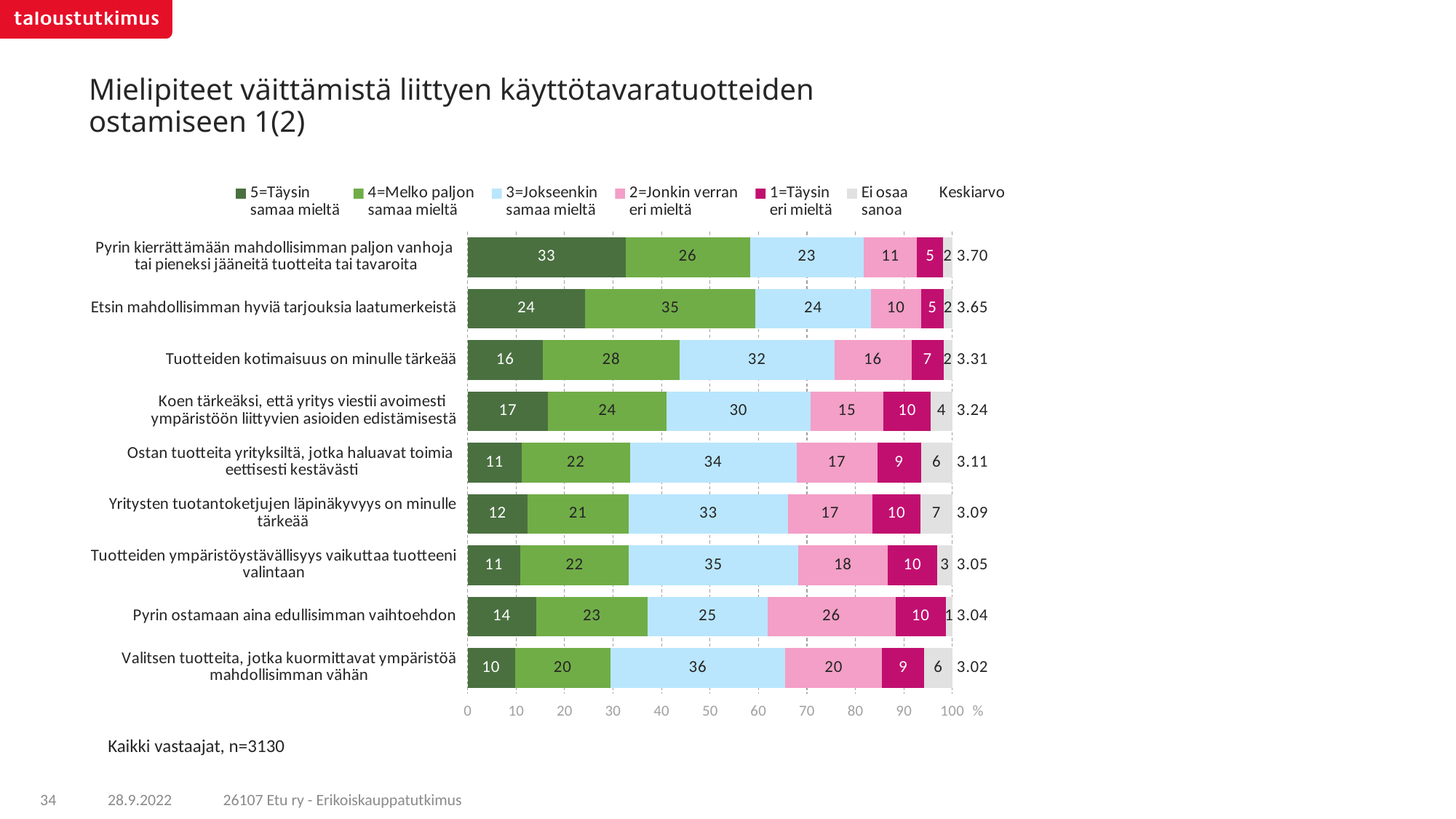
What is the "3=Jokseenkin samaa mieltä" value for "Valitsen tuotteita, jotka kuormittavat ympäristöä mahdollisimman vähän"? 36 Which statement has the lowest Keskiarvo? Valitsen tuotteita, jotka kuormittavat ympäristöä mahdollisimman vähän What percentage of respondents answered "5=Täysin samaa mieltä" to "Pyrin kierrättämään mahdollisimman paljon vanhoja tai pieneksi jääneitä tuotteita tai tavaroita"? 33 Which statement has the highest "2=Jonkin verran eri mieltä" share? Pyrin ostamaan aina edullisimman vaihtoehdon What kind of chart is shown on the slide? Stacked bar chart What is the "Ei osaa sanoa" value for "Yritysten tuotantoketjujen läpinäkyvyys on minulle tärkeää"? 7 Which statement has the highest "5=Täysin samaa mieltä" share? Pyrin kierrättämään mahdollisimman paljon vanhoja tai pieneksi jääneitä tuotteita tai tavaroita Which has the larger "2=Jonkin verran eri mieltä" value: "Pyrin ostamaan aina edullisimman vaihtoehdon" or "Tuotteiden kotimaisuus on minulle tärkeää"? Pyrin ostamaan aina edullisimman vaihtoehdon How much larger is the "4=Melko paljon samaa mieltä" value for "Etsin mahdollisimman hyviä tarjouksia laatumerkeistä" than for "Pyrin kierrättämään mahdollisimman paljon vanhoja tai pieneksi jääneitä tuotteita tai tavaroita"? 9 What is the Keskiarvo shown for "Tuotteiden kotimaisuus on minulle tärkeää"? 3.31 How many statements are shown in the chart? 9 How many response categories (series) does the legend list? 6